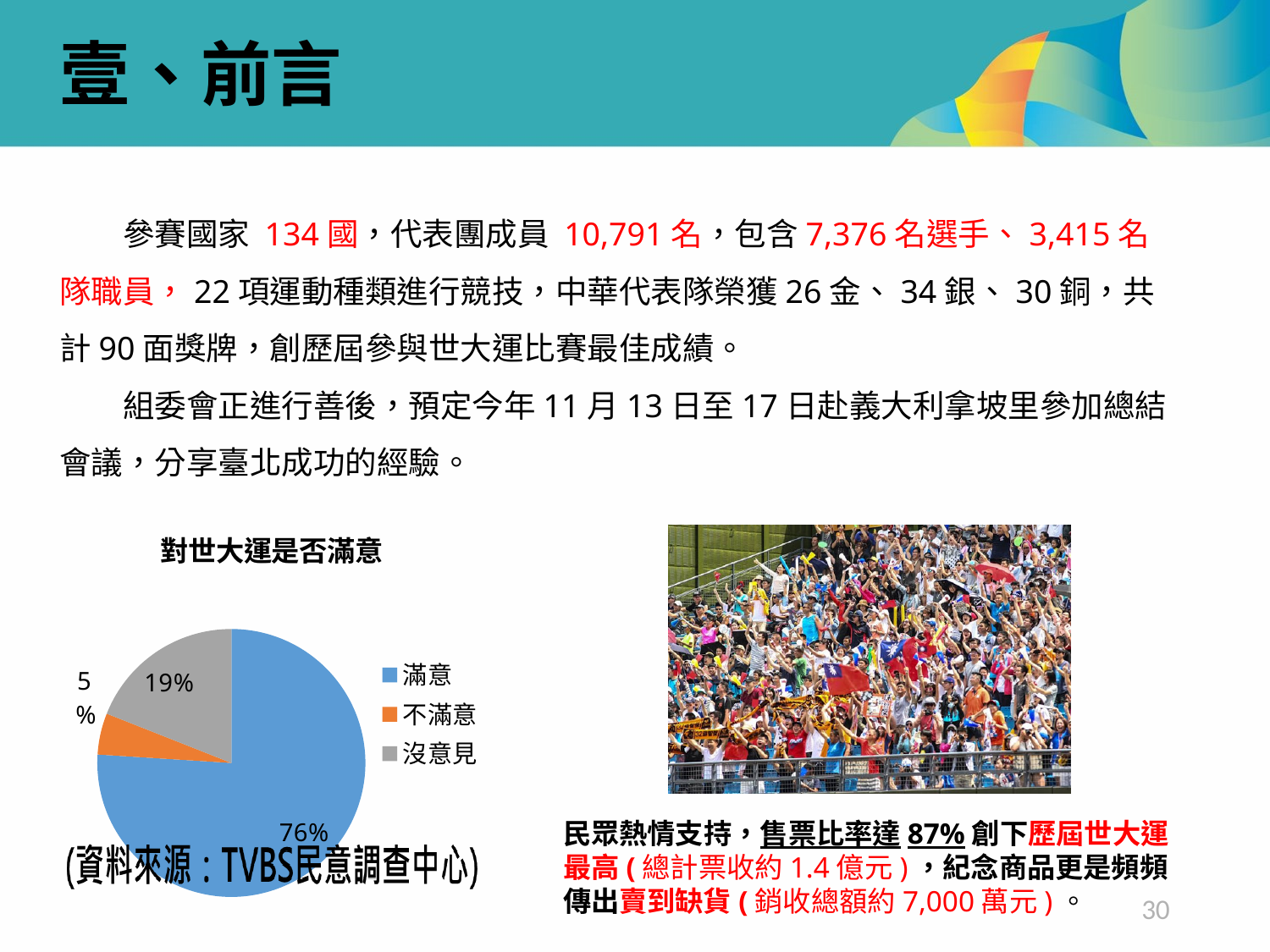
What is the difference in percentage points between 滿意 and 沒意見 in the pie chart? 57 What colour represents 不滿意 in the pie chart? orange How many entries does the legend of the pie chart list? 3 Which is larger in the pie chart, the share for 沒意見 or the share for 不滿意? 沒意見 What percentage of respondents answered 不滿意 in the pie chart? 5% What percentage of respondents answered 滿意 in the pie chart? 76% What percentage of respondents answered 沒意見 in the pie chart? 19% What is the title of the pie chart? 對世大運是否滿意 Which category has the largest share in the pie chart? 滿意 How many categories does the pie chart show? 3 What type of chart is shown on the slide? pie chart Which category has the smallest share in the pie chart? 不滿意